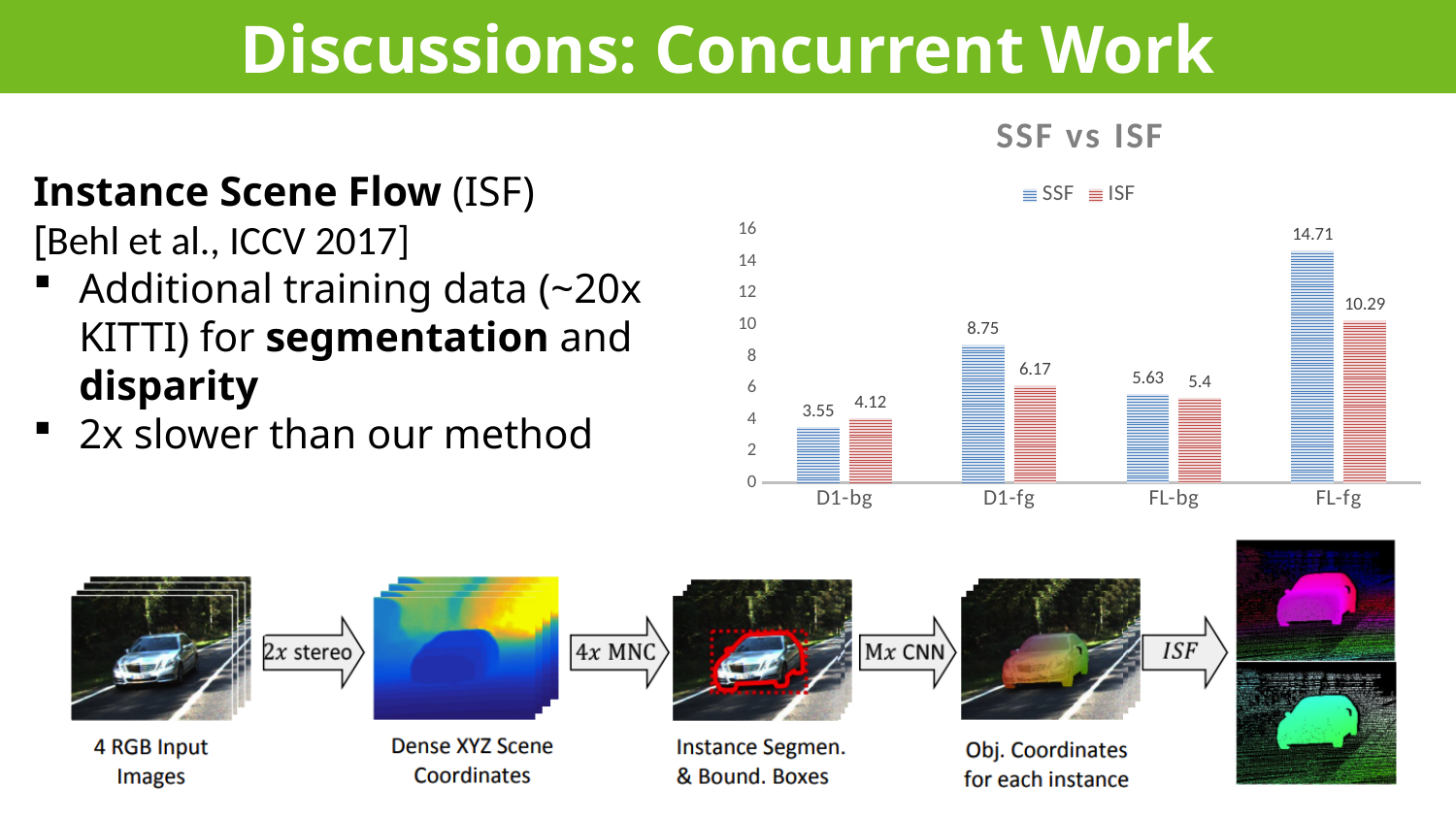
What kind of chart is shown? bar chart How many categories are shown on the x axis? 4 Which category has the lowest ISF value? D1-bg Which category has the highest SSF value? FL-fg What is the ISF value for FL-fg? 10.29 How many series does the legend list? 2 What is the SSF value for FL-bg? 5.63 For D1-fg, which is larger, the SSF value or the ISF value? SSF What is the ISF value for D1-bg? 4.12 What is the difference between the SSF and ISF values for FL-fg? 4.42 What is the title of the chart? SSF vs ISF What is the SSF value for D1-fg? 8.75